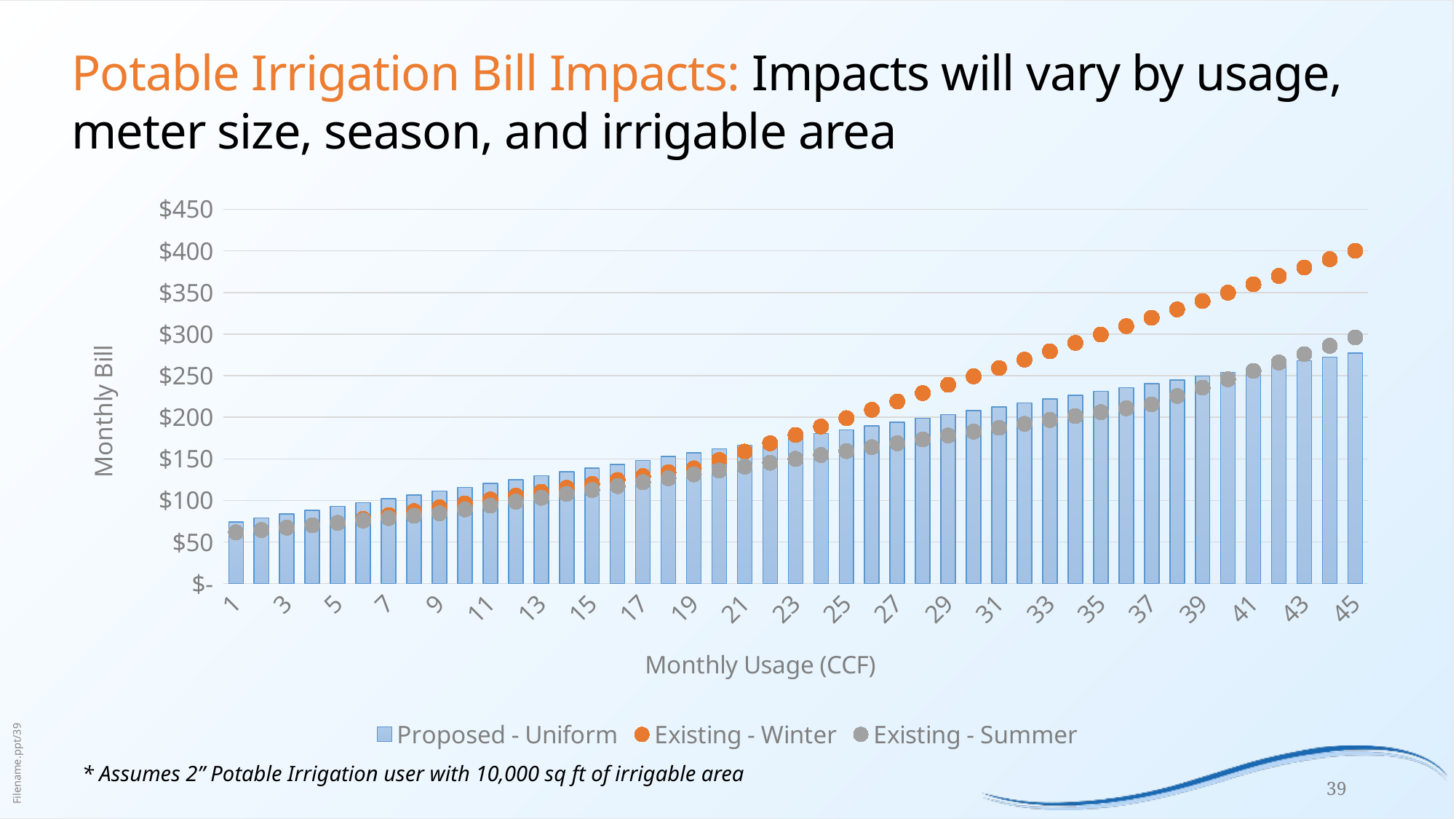
Is the Proposed - Uniform value at 1 CCF greater or less than $100? less Is the Proposed - Uniform value at 45 CCF greater or less than $300? less How many monthly usage levels (CCF) are plotted along the x axis? 45 Is the Existing - Winter value at 35 CCF greater or less than $250? greater What kind of chart is this? A combination bar and dot (scatter) chart Do the Proposed - Uniform bars rise or fall as monthly usage increases? Rise At 35 CCF, which is larger: Existing - Winter or Existing - Summer? Existing - Winter Which series has the highest monthly bill at 45 CCF? Existing - Winter At 1 CCF, which is larger: Proposed - Uniform or Existing - Winter? Proposed - Uniform How many series does the legend list? 3 What is the title of the x axis? Monthly Usage (CCF)